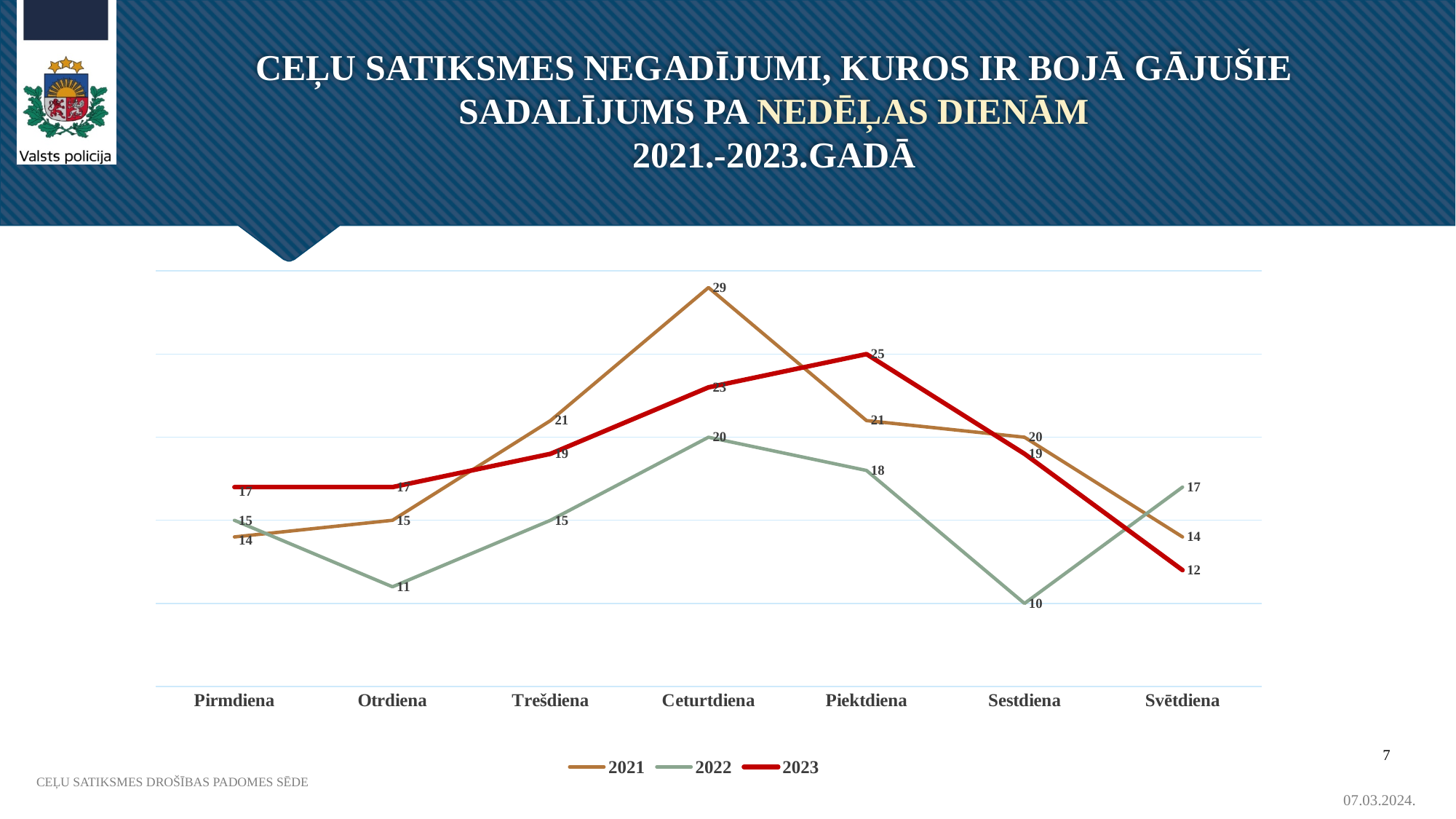
What is the value for 2022 on Sestdiena? 10 What is the value for 2021 on Ceturtdiena? 29 Which is larger on Svētdiena, the 2022 value or the 2023 value? 2022 How many series does the legend list? 3 Does the 2023 series rise or fall from Piektdiena to Svētdiena? fall What is the value for 2023 on Piektdiena? 25 What type of chart is shown on the slide? line chart Which series is drawn with the red line? 2023 What is the difference between the 2021 and 2022 values on Ceturtdiena? 9 On which day does the 2023 series have its lowest value? Svētdiena How many weekday categories are shown on the x axis? 7 On which day does the 2022 series reach its highest value? Ceturtdiena